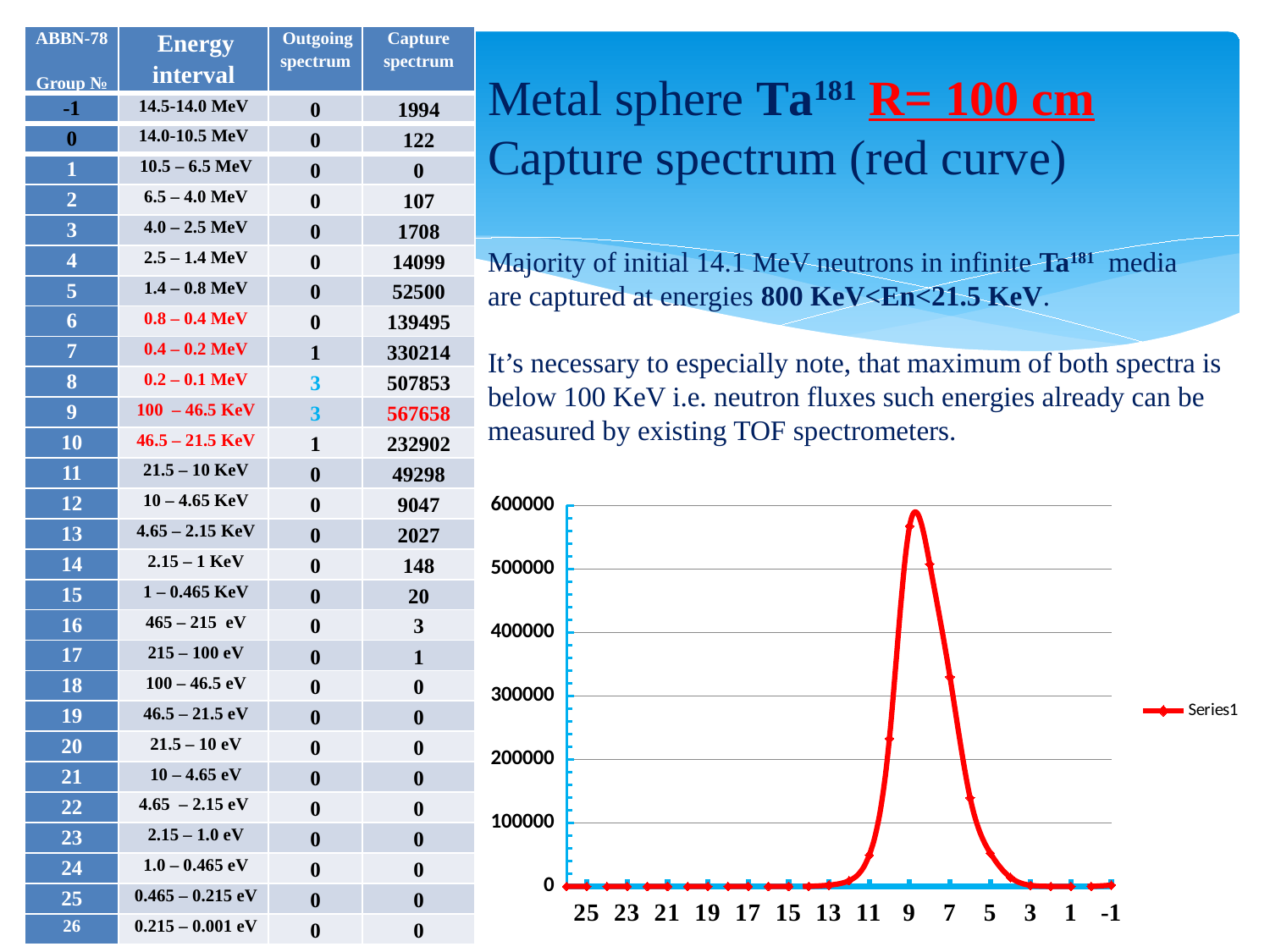
What is the name of the series shown in the chart legend? Series1 How many series does the chart legend list? 1 Which has the larger value, x = 10 or x = 6? 10 What is the highest tick value shown on the y axis? 600000 Is the value at x = 6 greater or less than 200000? less Moving along the x axis from 9 to -1, do the values rise or fall? fall Is the value at x = 11 greater or less than 100000? less Which has the larger value, x = 7 or x = 11? 7 At which x-axis value does the curve reach its highest point? 9 Is the value at x = 7 greater or less than 400000? less What kind of chart is shown on the slide? line chart